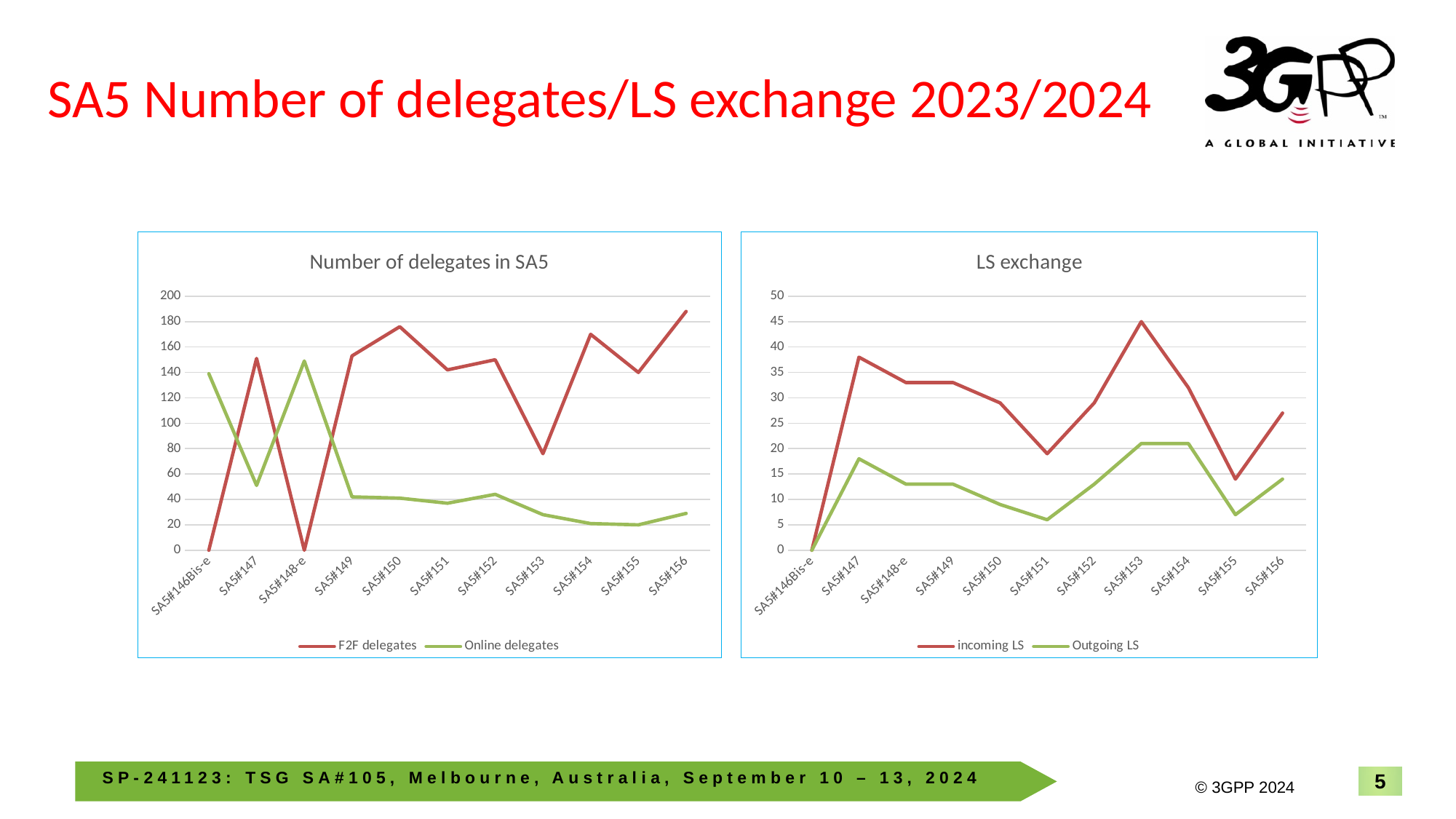
How many meetings are shown on the x axis of the "Number of delegates in SA5" chart? 11 In the "LS exchange" chart, at which meeting is incoming LS highest? SA5#153 What are the two legend entries of the "Number of delegates in SA5" chart? F2F delegates and Online delegates In the "LS exchange" chart, what is the value of incoming LS at SA5#146Bis-e? 0 In the "Number of delegates in SA5" chart, at which meeting is the number of F2F delegates highest? SA5#156 In the "LS exchange" chart, at SA5#151, which is larger: incoming LS or Outgoing LS? incoming LS How many series does the legend of the "LS exchange" chart list? 2 In the "Number of delegates in SA5" chart, is the value for F2F delegates at SA5#153 greater or less than 100? less In the "Number of delegates in SA5" chart, what is the value of F2F delegates at SA5#148-e? 0 What kind of chart is the "Number of delegates in SA5" chart? line chart In the "Number of delegates in SA5" chart, do Online delegates rise or fall from SA5#149 to SA5#155? fall In the "LS exchange" chart, is the value for incoming LS at SA5#147 greater or less than 35? greater